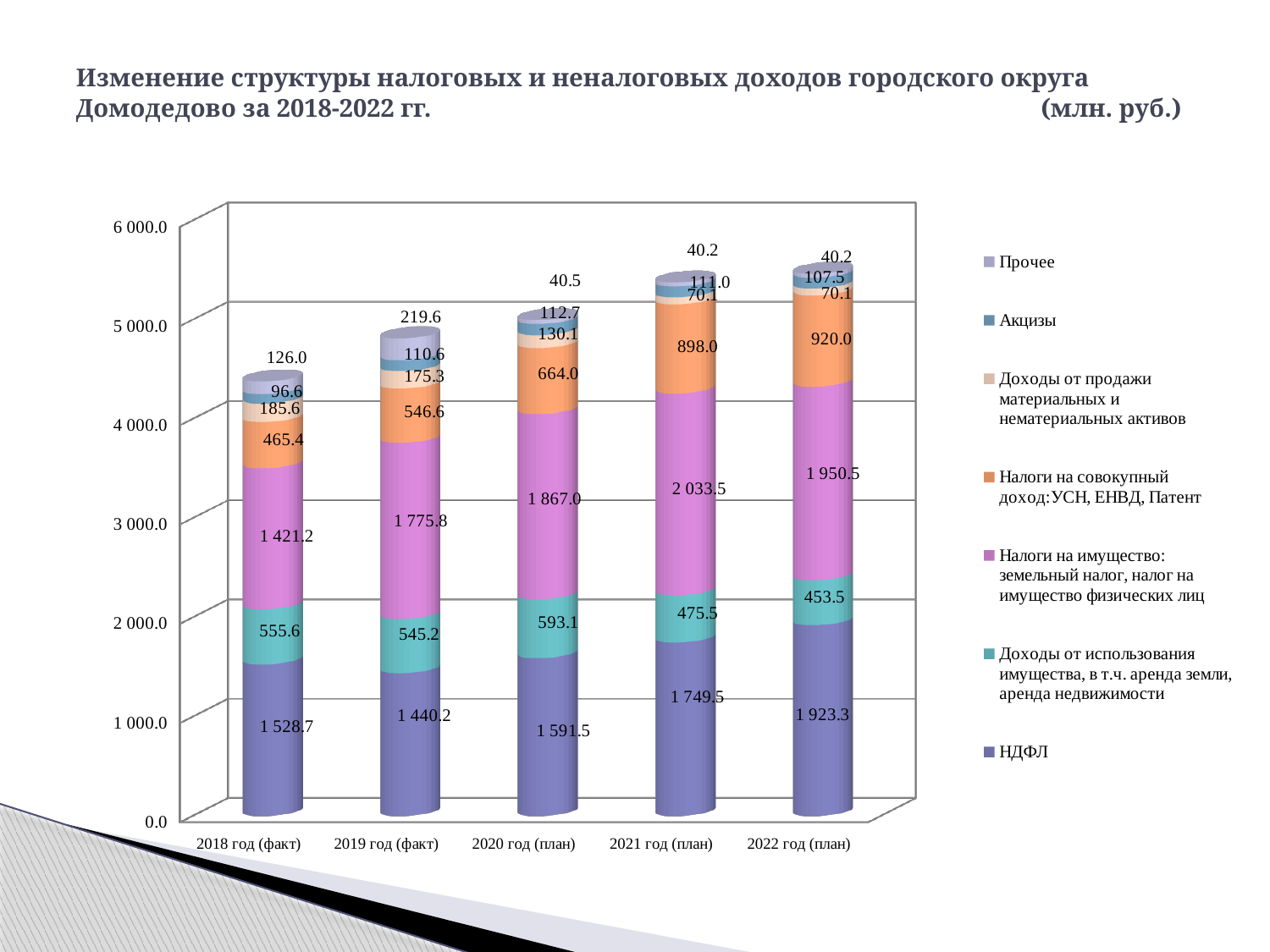
What is the total of the stacked bar for 2018 год (факт)? 4 379.1 How many year categories are shown on the x axis? 5 What is the difference between the Налоги на имущество values for 2021 год (план) and 2020 год (план)? 166.5 Which year has the larger value for Доходы от использования имущества: 2020 год (план) or 2021 год (план)? 2020 год (план) What is the value of Акцизы for 2019 год (факт)? 110.6 Do the values for Налоги на совокупный доход: УСН, ЕНВД, Патент rise or fall from 2018 to 2022? Rise In which year is the value for Налоги на имущество: земельный налог, налог на имущество физических лиц the lowest? 2018 год (факт) In which year is the НДФЛ value the highest? 2022 год (план) What is the value of Налоги на совокупный доход: УСН, ЕНВД, Патент for 2021 год (план)? 898.0 What is the value of НДФЛ for 2022 год (план)? 1 923.3 How many series does the legend list? 7 What kind of chart is shown on the slide? Stacked bar chart